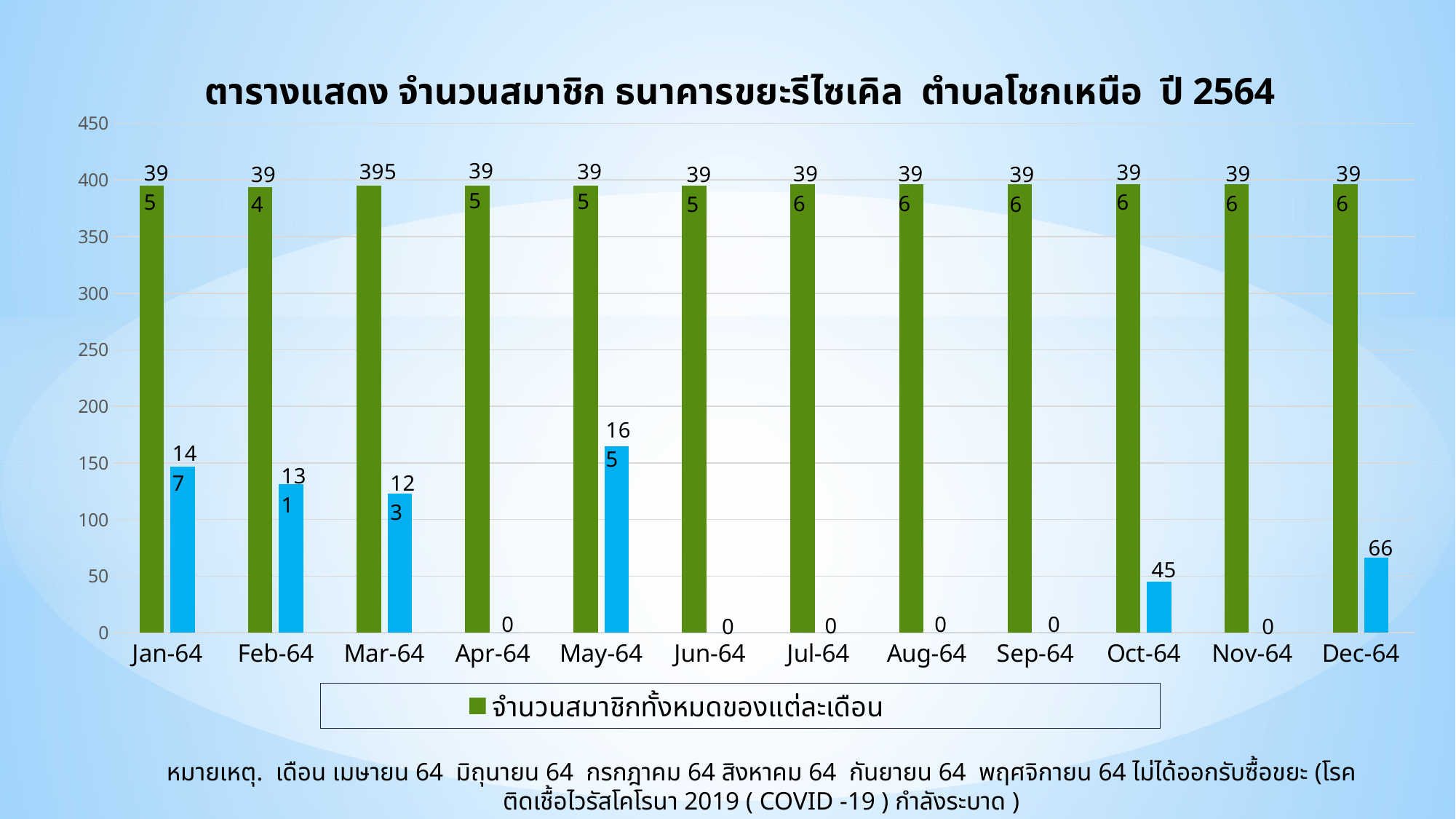
What kind of chart is shown on the slide? Bar chart What is the value of the blue bar for Apr-64? 0 What is the value of the green bar for Mar-64? 395 How many months have a blue bar value of 0? 6 Which is larger, the blue bar for Jan-64 or the blue bar for Feb-64? Jan-64 Which month has the highest blue bar? May-64 Is the value of the green bar for Jun-64 greater or less than 350? greater How many series does the legend list? 1 What is the value of the blue bar for Dec-64? 66 What is the difference between the blue bar values for Dec-64 and Oct-64? 21 How many months are shown on the x axis? 12 What is the value of the blue bar for Oct-64? 45